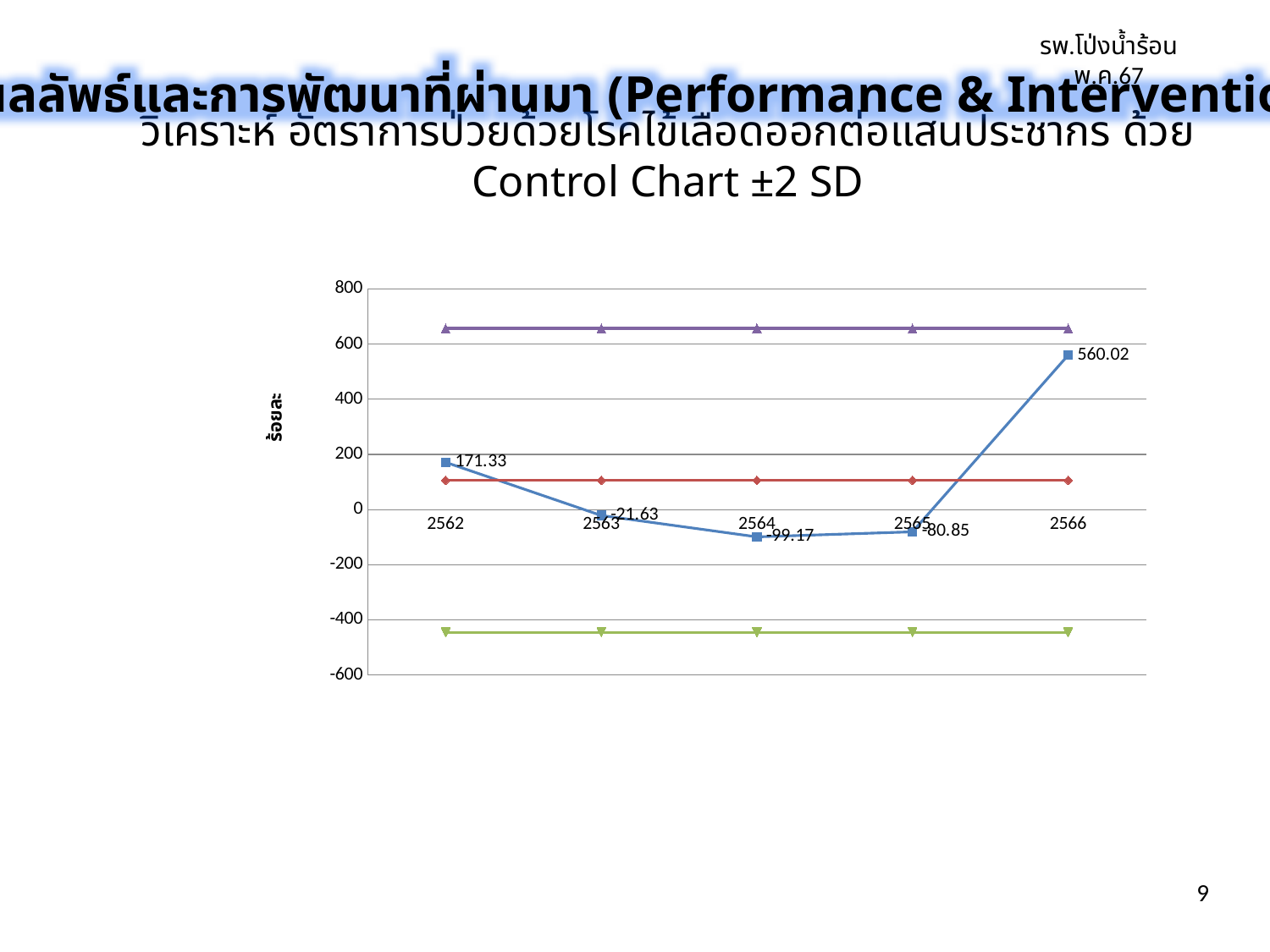
Which year has the larger value on the blue data line, 2562 or 2565? 2562 What is the difference between the blue line's values for 2566 and 2562? 388.69 Is the value of the green lower line greater or less than -400? less What is the value of the blue data line for 2564? -99.17 In which year does the blue data line reach its highest value? 2566 What is the value of the blue data line for 2563? -21.63 What is the value of the blue data line for 2566? 560.02 Is the value of the purple upper line greater or less than 600? greater In which year does the blue data line reach its lowest value? 2564 What is the value of the blue data line for 2562? 171.33 How many years are shown on the x axis of the chart? 5 What type of chart is shown on the slide? Line chart